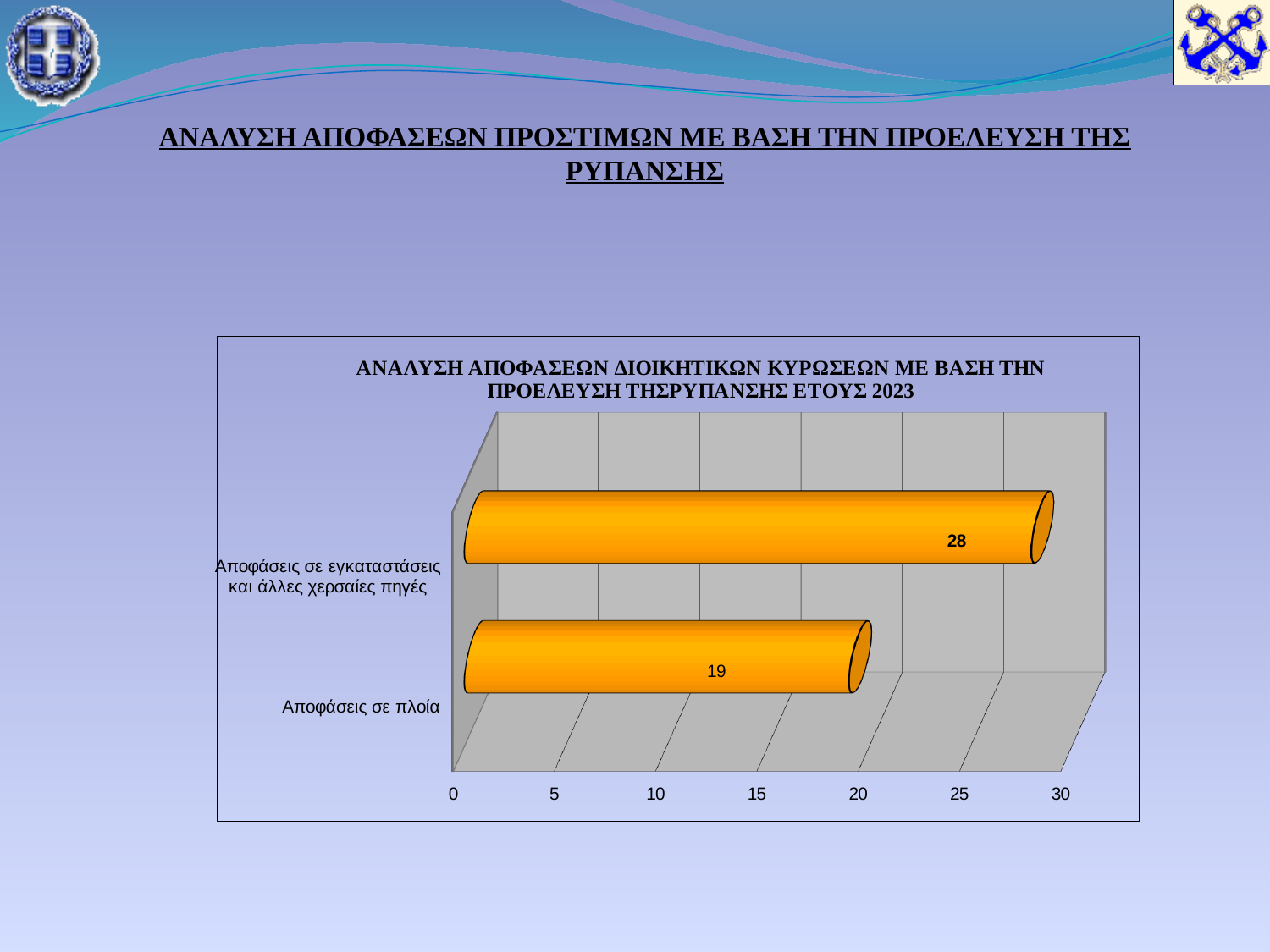
Is the value for Αποφάσεις σε πλοία greater or less than 20? less How many categories are shown in the chart? 2 Which is larger: the value for Αποφάσεις σε πλοία or the value for Αποφάσεις σε εγκαταστάσεις και άλλες χερσαίες πηγές? Αποφάσεις σε εγκαταστάσεις και άλλες χερσαίες πηγές What is the value for Αποφάσεις σε πλοία? 19 What is the total of the two values shown in the chart? 47 What is the difference between the value for Αποφάσεις σε εγκαταστάσεις και άλλες χερσαίες πηγές and the value for Αποφάσεις σε πλοία? 9 Which category has the highest value? Αποφάσεις σε εγκαταστάσεις και άλλες χερσαίες πηγές What is the highest value shown on the horizontal axis of the chart? 30 Is the value for Αποφάσεις σε εγκαταστάσεις και άλλες χερσαίες πηγές greater or less than 25? greater What is the value for Αποφάσεις σε εγκαταστάσεις και άλλες χερσαίες πηγές? 28 Which category has the lowest value? Αποφάσεις σε πλοία What kind of chart is shown on the slide? bar chart